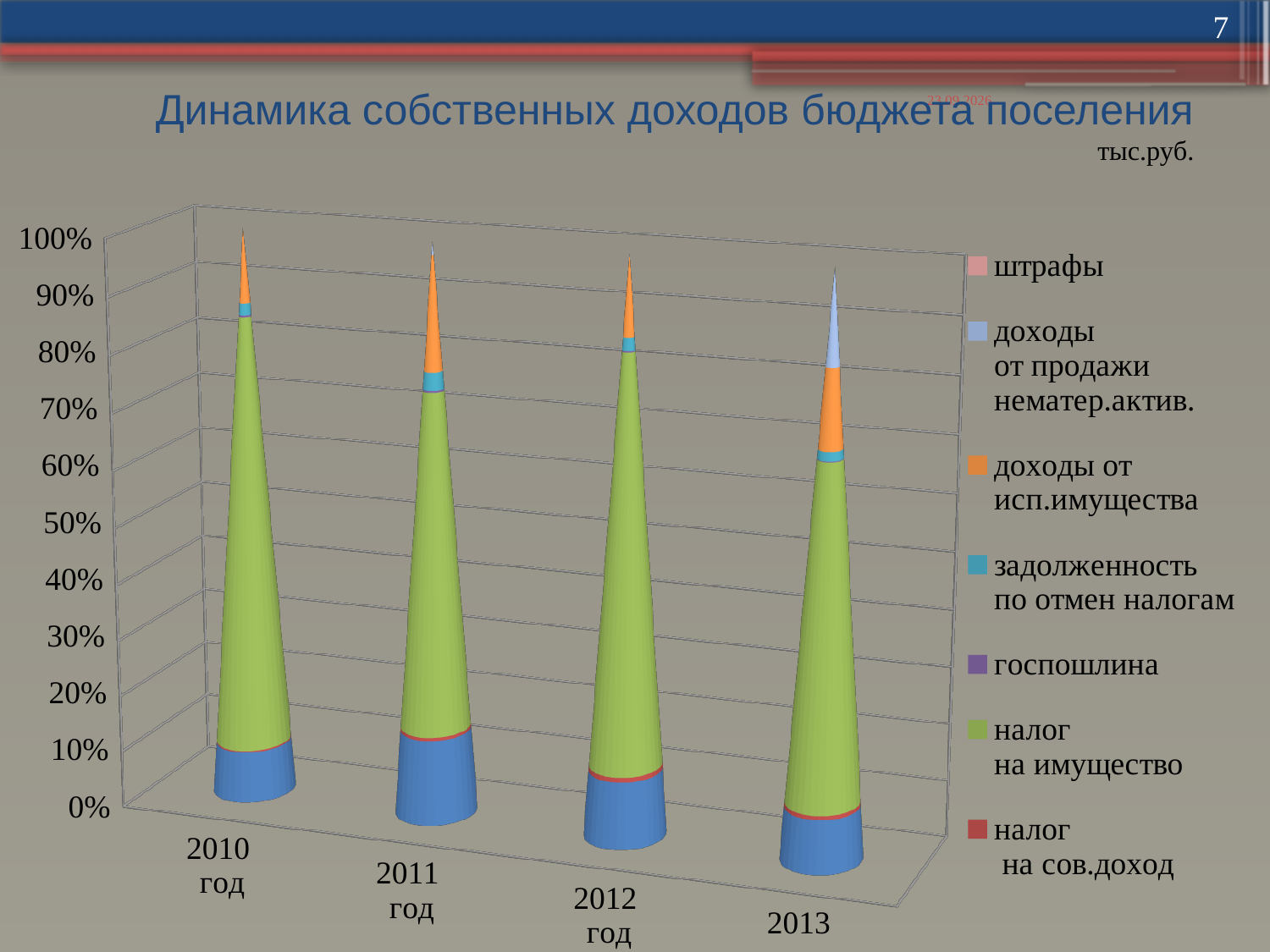
What is the first year shown on the x axis? 2010 год Is the share of 'налог на имущество' in 2012 greater or less than 50%? greater Is the share of 'доходы от исп.имущества' in 2013 greater or less than 30%? less How many years are shown along the x axis of the chart? 4 Is the share of 'налог на имущество' larger in 2010 or in 2013? 2010 What is the title of the chart? Динамика собственных доходов бюджета поселения What kind of chart is shown on the slide? stacked bar chart Is the share of 'налог на имущество' in 2010 greater or less than 50%? greater What is the maximum value shown on the y axis? 100% How many series does the chart legend list? 7 In which year is the share of 'доходы от продажи нематер.актив.' the largest? 2013 Which colour represents 'налог на имущество' in the legend? green